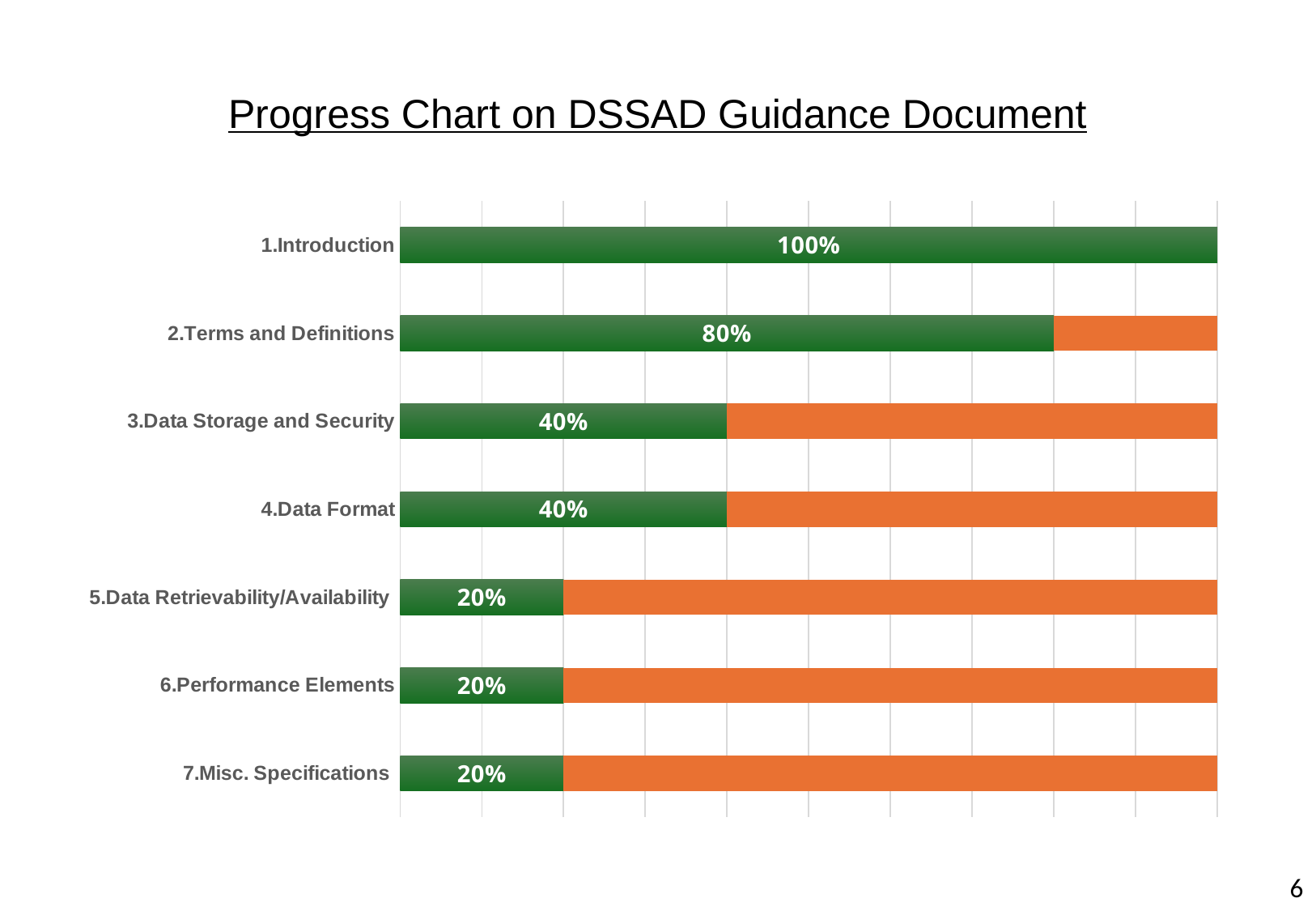
Which category has the highest progress value? 1.Introduction What is the progress value shown for 3.Data Storage and Security? 40% What is the difference between the progress values for 1.Introduction and 2.Terms and Definitions? 20% How many categories have a progress value of 20%? 3 How many categories are shown in the chart? 7 What colour is used for the completed progress portion of each bar? Green Which has a larger progress value, 2.Terms and Definitions or 3.Data Storage and Security? 2.Terms and Definitions What kind of chart is shown on the slide? Bar chart What is the progress value shown for 2.Terms and Definitions? 80% What is the progress value shown for 6.Performance Elements? 20% What is the difference between the progress values for 4.Data Format and 5.Data Retrievability/Availability? 20% What is the title of the chart on the slide? Progress Chart on DSSAD Guidance Document